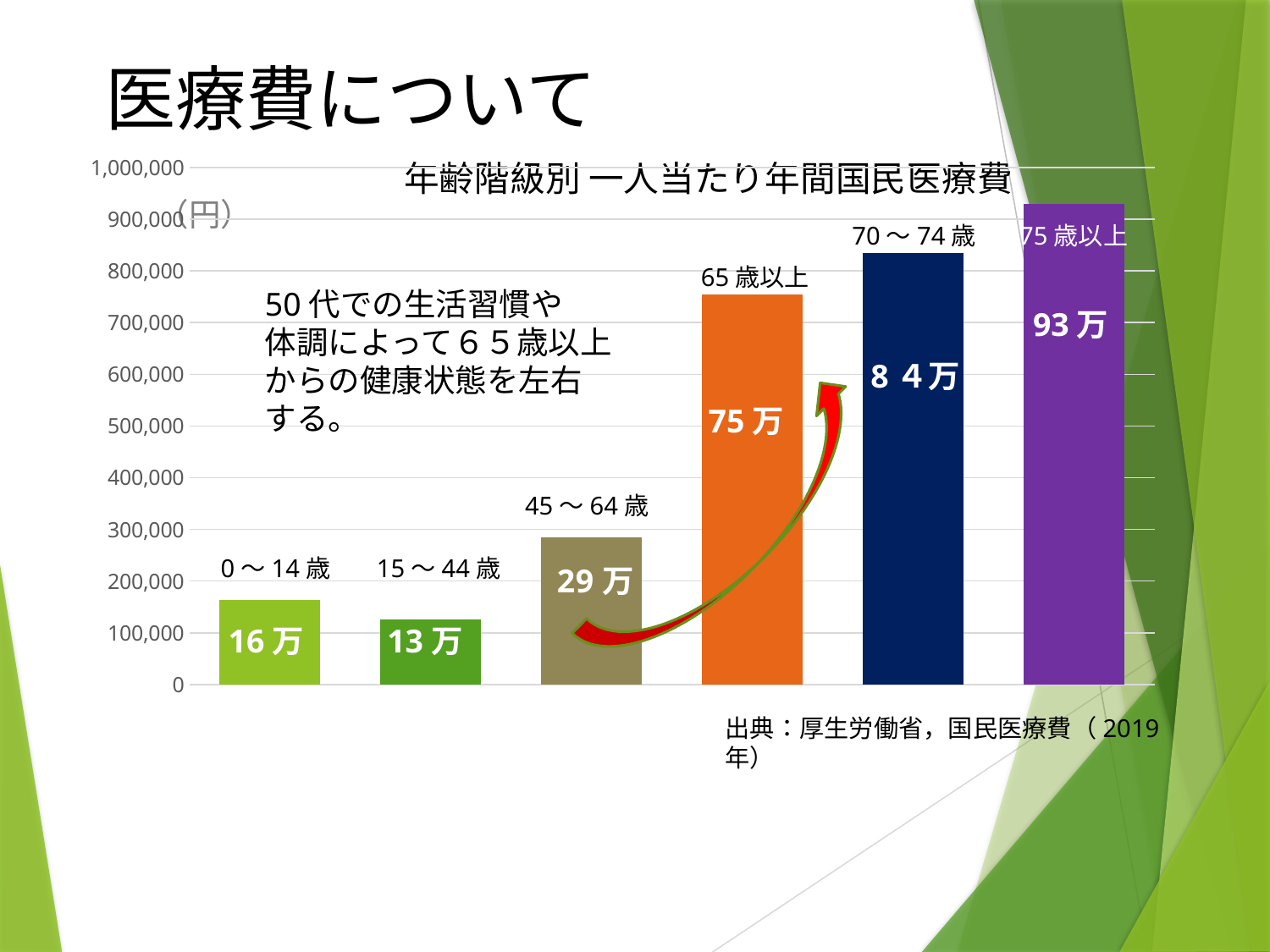
Which age category has the lowest value? 15～44歳 What is the difference between the values for 75歳以上 and 70～74歳? 9万 What is the value shown for the 45～64歳 category? 29万 Which is larger, the value for 65歳以上 or the value for 45～64歳? 65歳以上 How many age categories are shown in the chart? 6 Which age category has the highest value? 75歳以上 What is the value shown for the 70～74歳 category? ８４万 What is the difference between the values for 45～64歳 and 15～44歳? 16万 What kind of chart is shown on the slide? bar chart Is the value for 65歳以上 greater or less than 700,000? greater What is the value shown for the 0～14歳 category? 16万 What is the title of the chart? 年齢階級別 一人当たり年間国民医療費